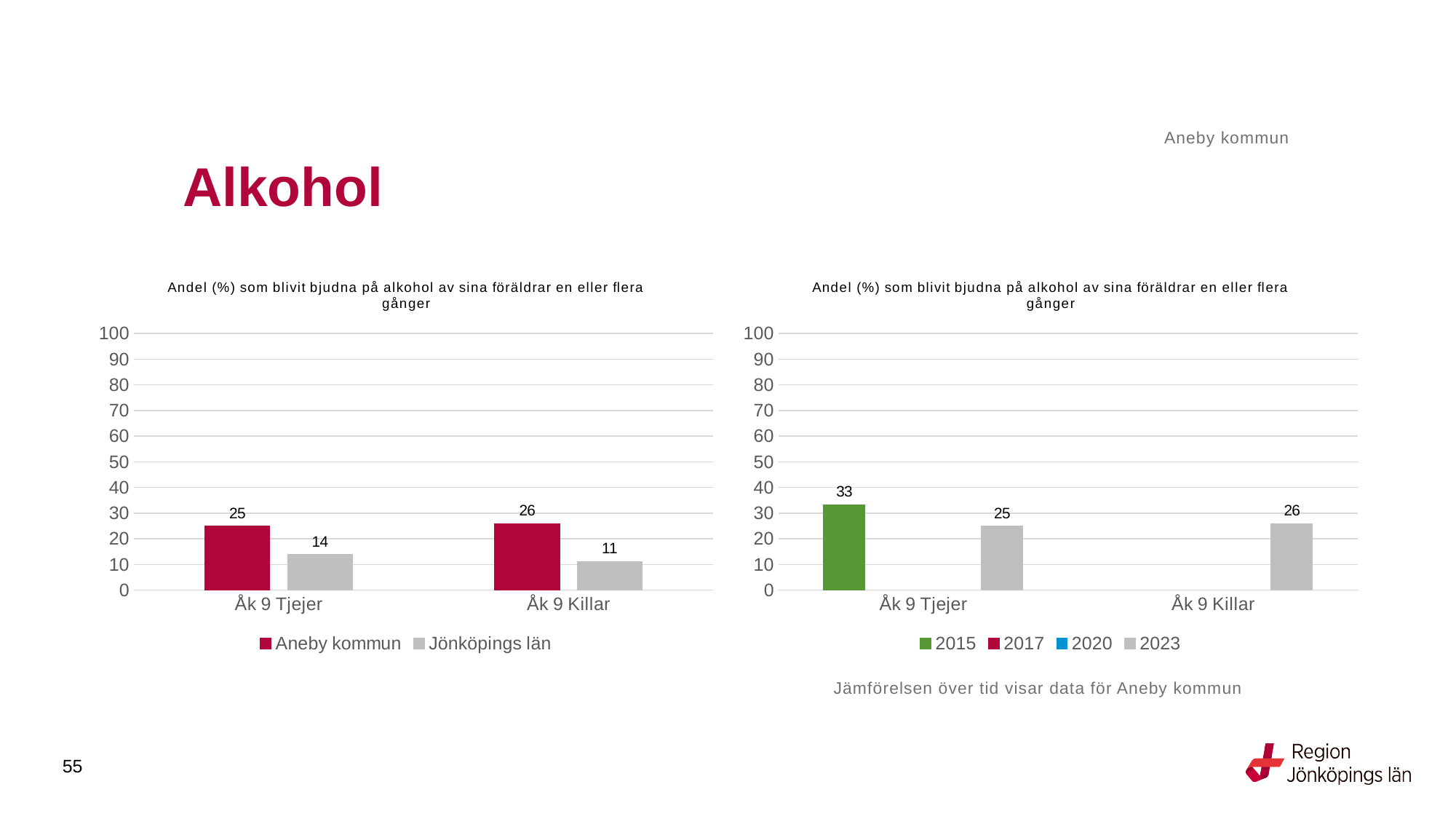
In the left chart, which is larger for Åk 9 Killar: Aneby kommun or Jönköpings län? Aneby kommun In the right chart, what is the difference between the 2015 and 2023 values for Åk 9 Tjejer? 8 In the left chart, what is the value for Jönköpings län for Åk 9 Killar? 11 In the right chart, what is the value for 2015 for Åk 9 Tjejer? 33 What kind of chart is the right chart? Bar chart How many series does the legend of the left chart list? 2 In the right chart, what is the value for 2023 for Åk 9 Killar? 26 How many series does the legend of the right chart list? 4 In the left chart, what is the value for Aneby kommun for Åk 9 Tjejer? 25 In the left chart, what is the difference between Aneby kommun and Jönköpings län for Åk 9 Tjejer? 11 In the left chart, which category has the lowest value for Jönköpings län? Åk 9 Killar In the right chart, is the 2015 value for Åk 9 Tjejer greater or less than 30? greater